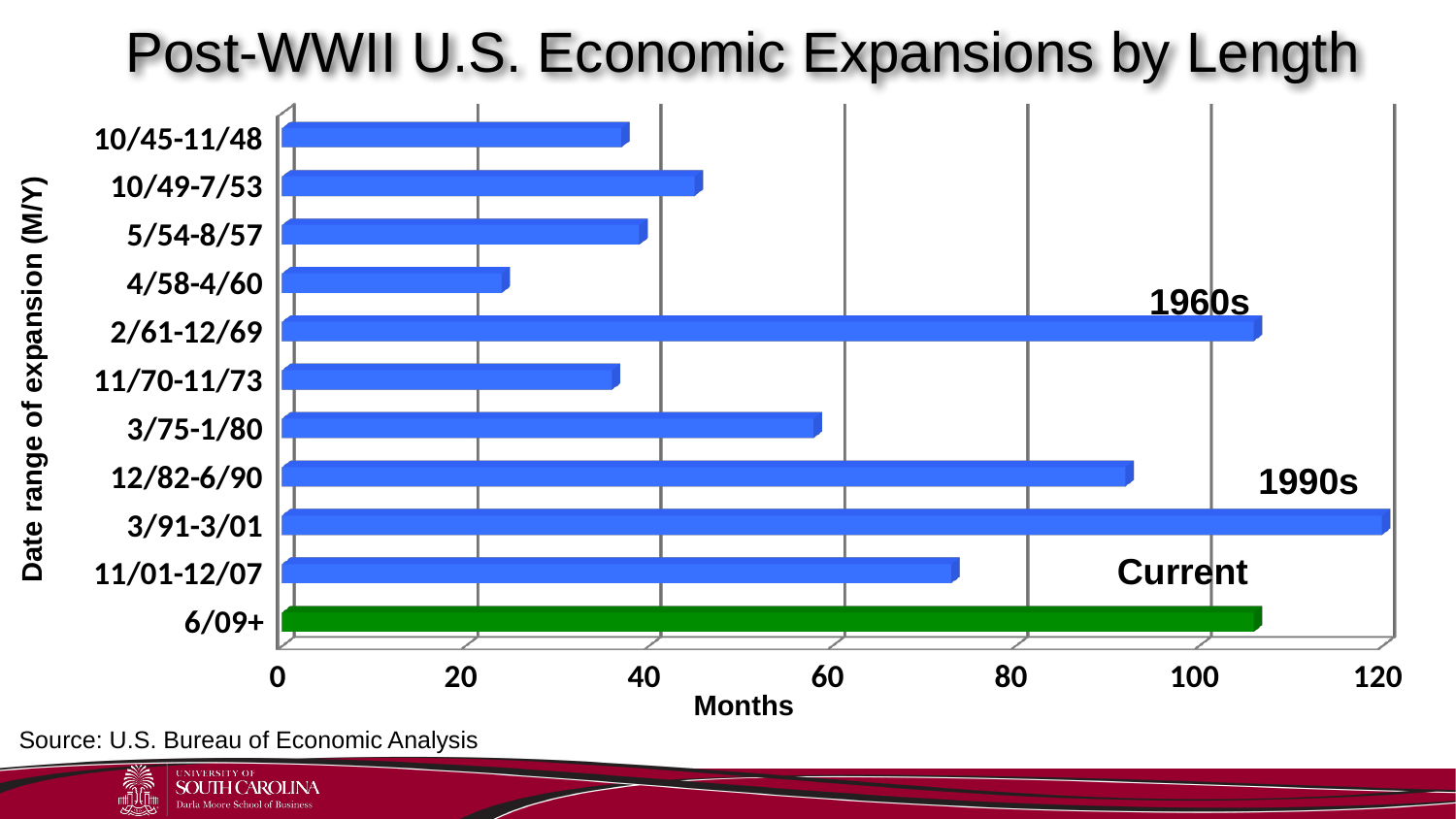
Is the value for 2/61-12/69 greater or less than 100 months? greater What kind of chart is shown on the slide? bar chart Is the value for 11/01-12/07 greater or less than 80 months? less Is the value for 4/58-4/60 greater or less than 40 months? less How many months long is the 3/91-3/01 expansion according to the chart? 120 What is the label on the x axis of the chart? Months Which is longer, the 3/75-1/80 expansion or the 10/49-7/53 expansion? 3/75-1/80 How many expansion periods (bars) are plotted in the chart? 11 Which expansion period is shown with a green bar? 6/09+ Which expansion period has the shortest bar? 4/58-4/60 Which expansion period has the longest bar? 3/91-3/01